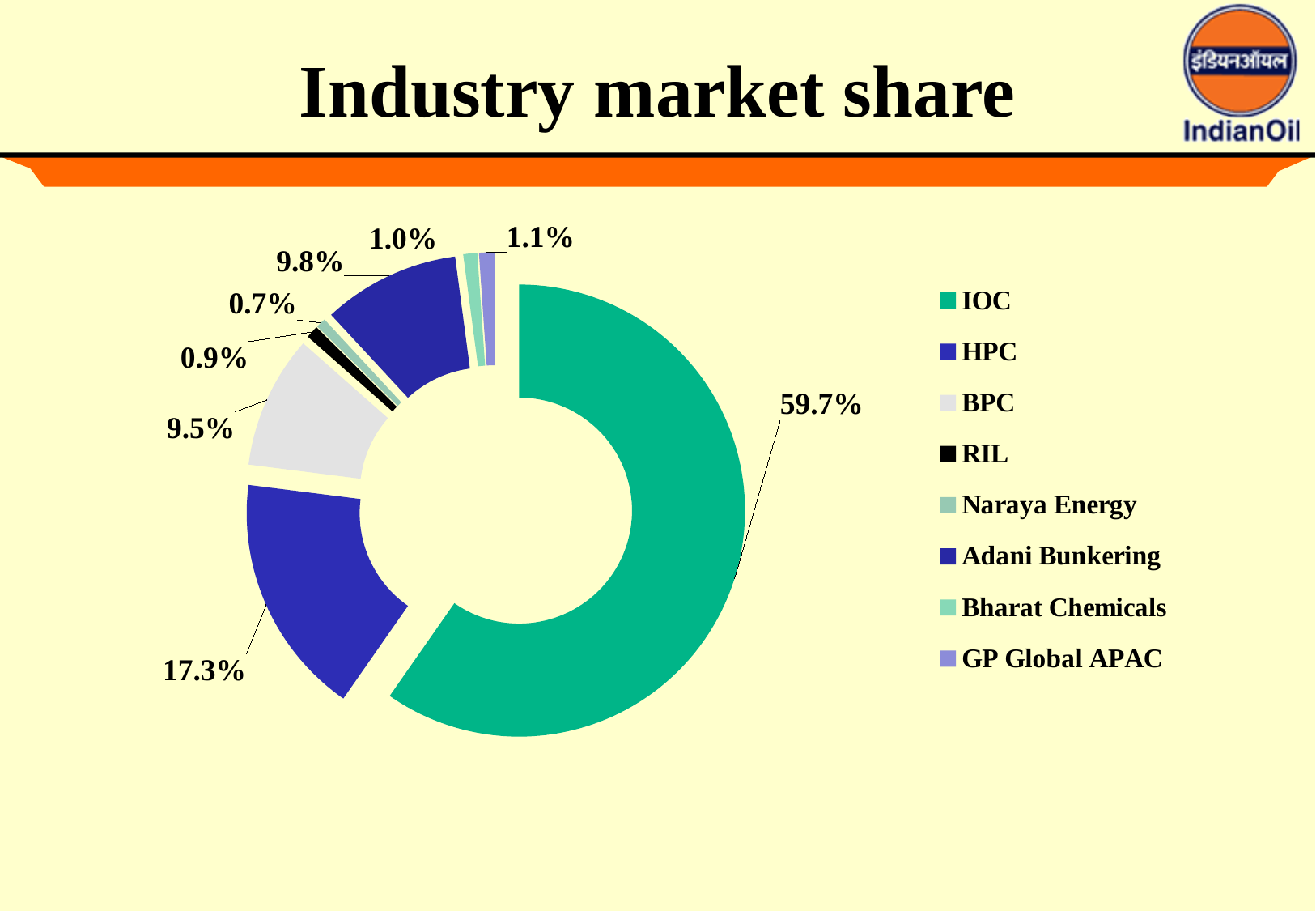
How many companies are listed in the legend? 8 What market share does Adani Bunkering hold? 9.8% What market share does HPC hold? 17.3% What is the difference between IOC's and HPC's market shares? 42.4% What kind of chart is shown on the slide? Pie chart (doughnut) What market share does IOC hold? 59.7% What market share does BPC hold? 9.5% Which company has the largest market share? IOC What market share does GP Global APAC hold? 1.1% What share of the pie does the IOC slice represent? 59.7% What is the title of the chart? Industry market share Which has the larger market share, BPC or Adani Bunkering? Adani Bunkering